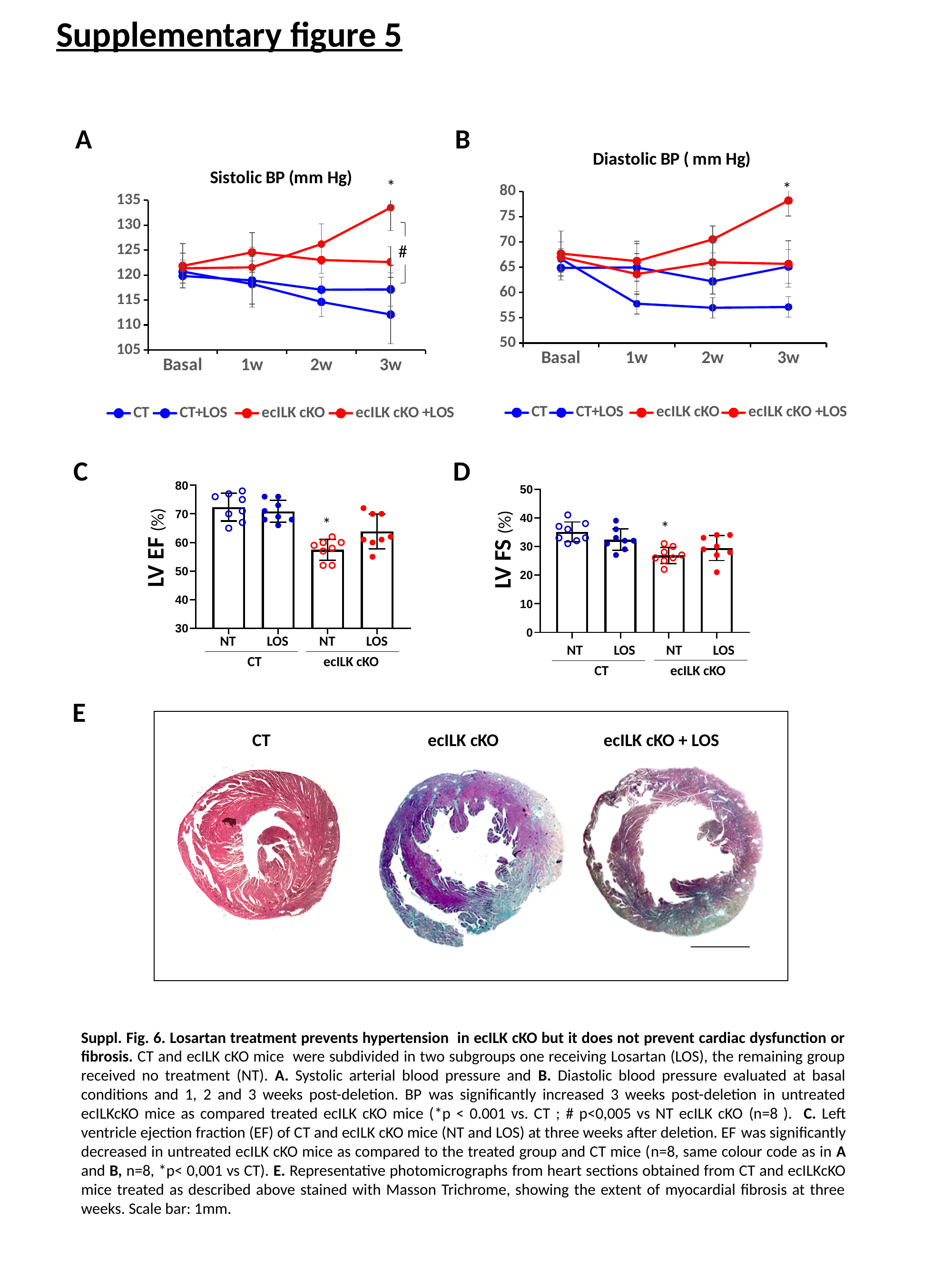
In chart C (LV EF), is the bar for ecILK cKO NT greater or less than 60? less What kind of chart is chart C (LV EF)? bar chart What is the title of chart B? Diastolic BP ( mm Hg) What kind of chart is chart A (Sistolic BP)? line chart How many series does the legend of chart A (Sistolic BP) list? 4 In chart B (Diastolic BP), is the lowest value at 3w greater or less than 60? less How many time points are shown on the x axis of chart B (Diastolic BP)? 4 In chart C (LV EF), which bar is taller: ecILK cKO NT or ecILK cKO LOS? ecILK cKO LOS In chart B (Diastolic BP), is the highest value at 3w greater or less than 75? greater In chart C (LV EF), which group has the lowest bar? ecILK cKO NT In chart D (LV FS), which group has the highest bar? CT NT